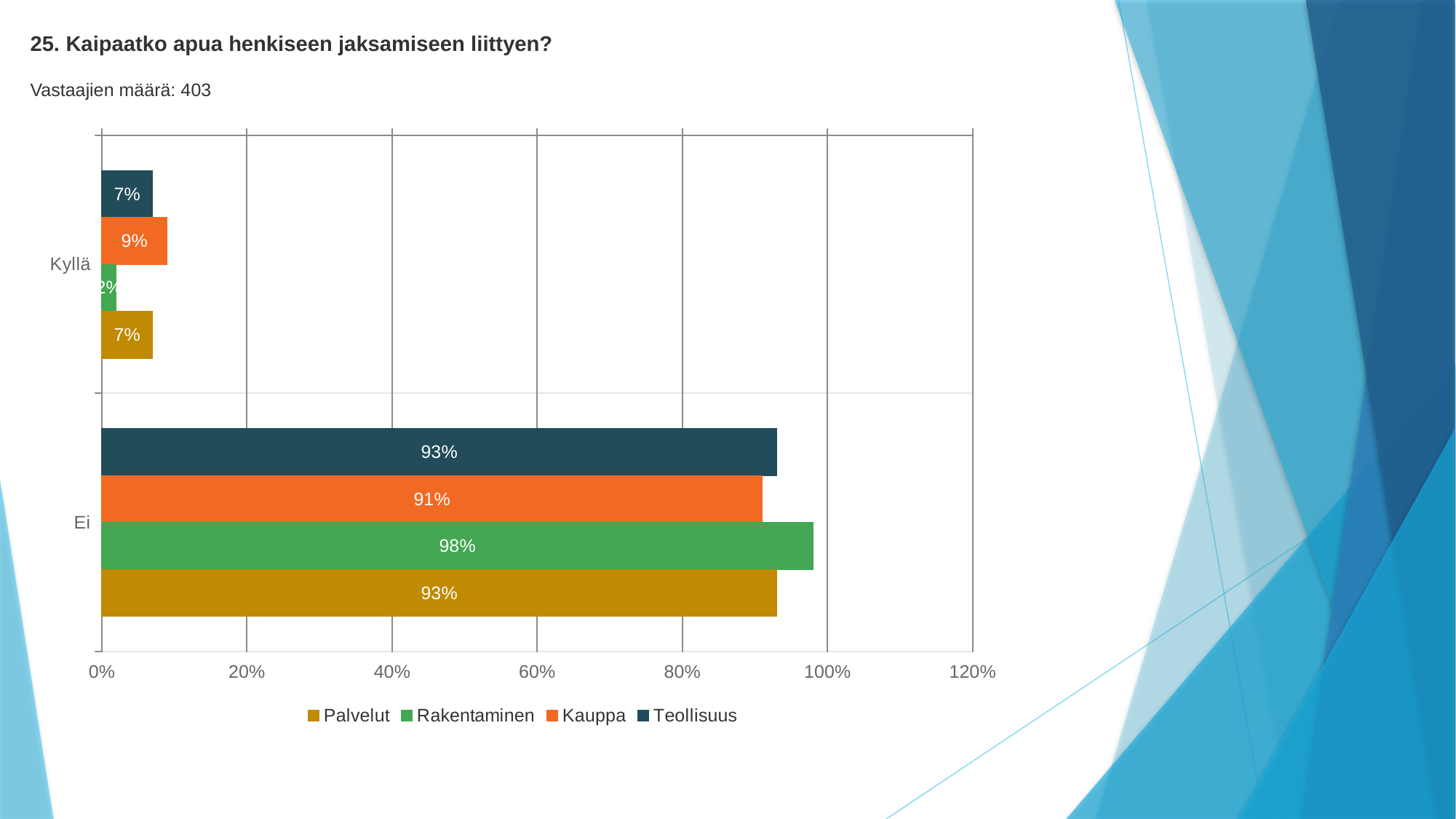
Is the value for Kauppa in the Ei category greater or less than 80%? greater What is the value for Teollisuus in the Ei category? 93% How many answer categories are shown on the vertical axis? 2 Which series has the highest value in the Ei category? Rakentaminen What kind of chart is shown on the slide? bar chart What is the value for Rakentaminen in the Ei category? 98% What is the value for Kauppa in the Kyllä category? 9% In the Kyllä category, which is larger: the value for Kauppa or the value for Palvelut? Kauppa What is the difference between the Rakentaminen and Kauppa values in the Ei category? 7% Which series has the lowest value in the Kyllä category? Rakentaminen What is the number of respondents stated on the slide? 403 How many series does the legend list? 4